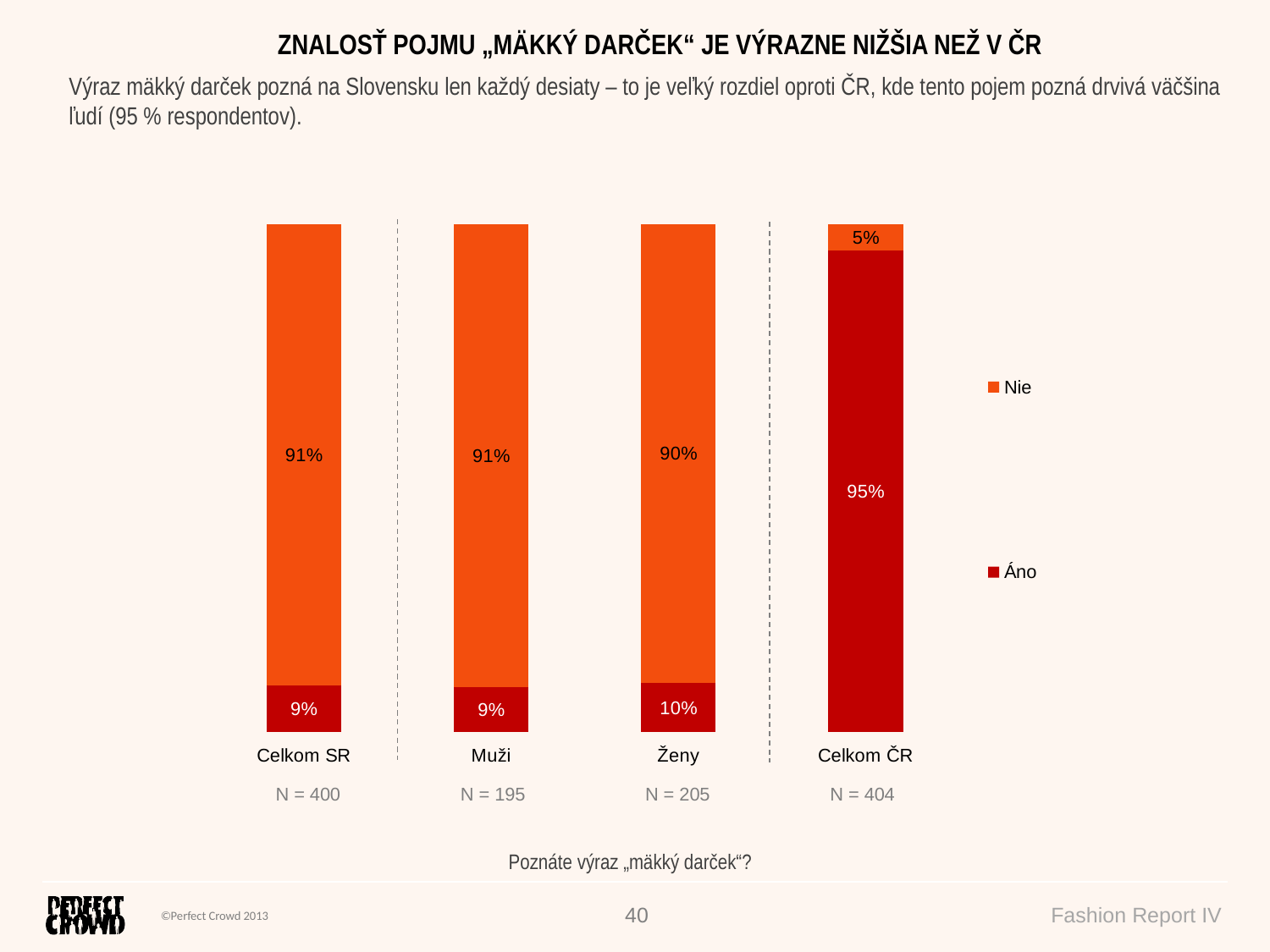
What is the "Nie" value for Ženy? 90% How many categories are shown on the x axis? 4 What is the difference between the "Áno" value for Celkom ČR and the "Áno" value for Celkom SR? 86% What is the "Nie" value for Muži? 91% What is the total of the stacked bar for Ženy? 100% What is the "Áno" value for Celkom ČR? 95% Which category has the lowest "Nie" value? Celkom ČR Which category has the highest "Áno" value? Celkom ČR What is the "Áno" value for Celkom SR? 9% What kind of chart is shown on the slide? Stacked bar chart Which is larger: the "Áno" value for Ženy or the "Áno" value for Muži? Ženy How many series does the legend list? 2